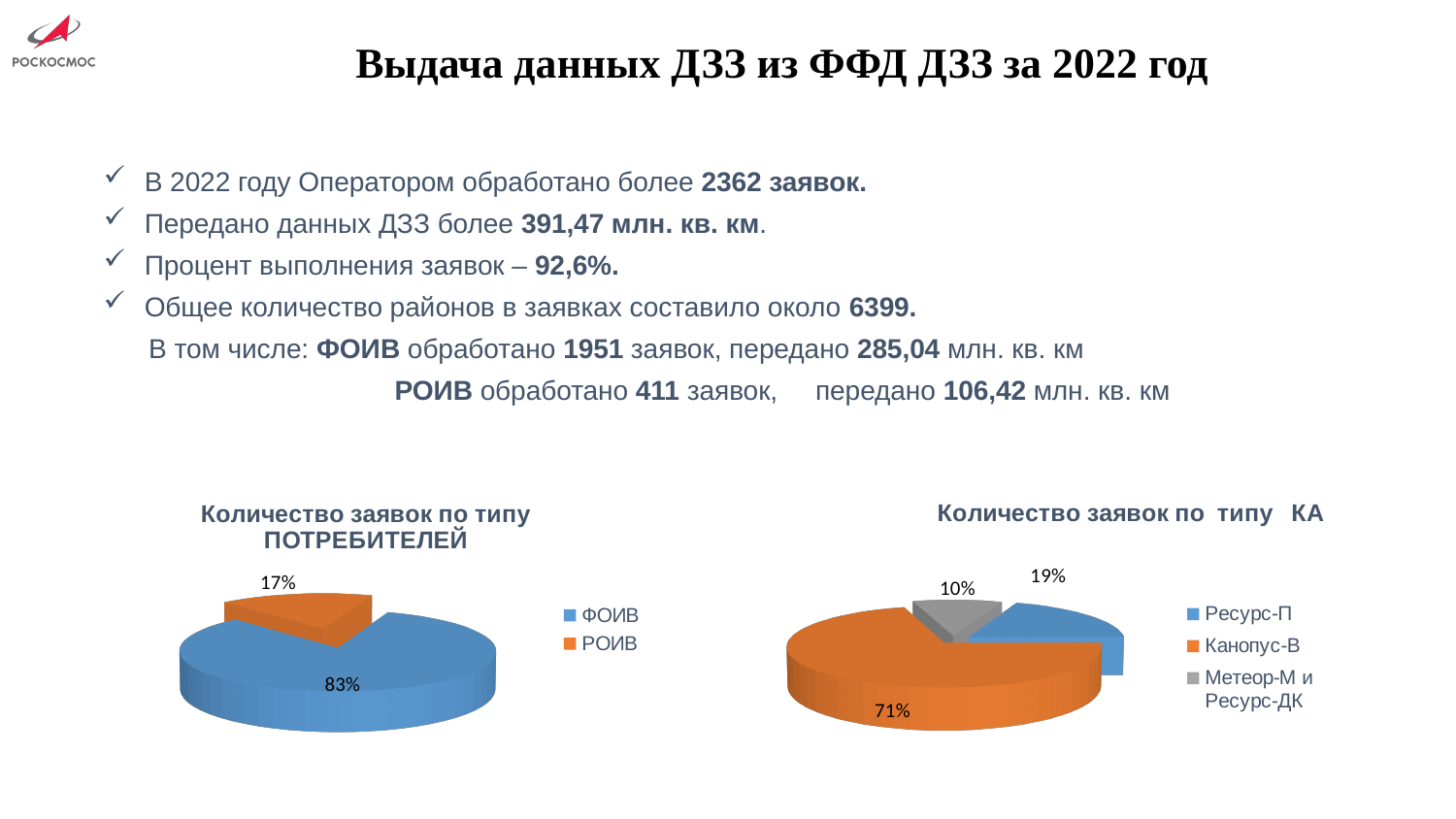
What kind of chart is the one titled "Количество заявок по типу ПОТРЕБИТЕЛЕЙ"? Pie chart In the chart titled "Количество заявок по типу ПОТРЕБИТЕЛЕЙ", what is the difference in percentage points between the ФОИВ and РОИВ slices? 66 How many categories does the legend of the chart titled "Количество заявок по типу КА" list? 3 In the chart titled "Количество заявок по типу ПОТРЕБИТЕЛЕЙ", what share of requests is attributed to РОИВ? 17% In the chart titled "Количество заявок по типу КА", which slice is larger: Ресурс-П or Метеор-М и Ресурс-ДК? Ресурс-П In the chart titled "Количество заявок по типу КА", what share of requests is attributed to Метеор-М и Ресурс-ДК? 10% In the chart titled "Количество заявок по типу ПОТРЕБИТЕЛЕЙ", which category has the largest slice? ФОИВ In the chart titled "Количество заявок по типу КА", what share of requests is attributed to Ресурс-П? 19% In the chart titled "Количество заявок по типу КА", which category has the smallest slice? Метеор-М и Ресурс-ДК How many categories does the legend of the chart titled "Количество заявок по типу ПОТРЕБИТЕЛЕЙ" list? 2